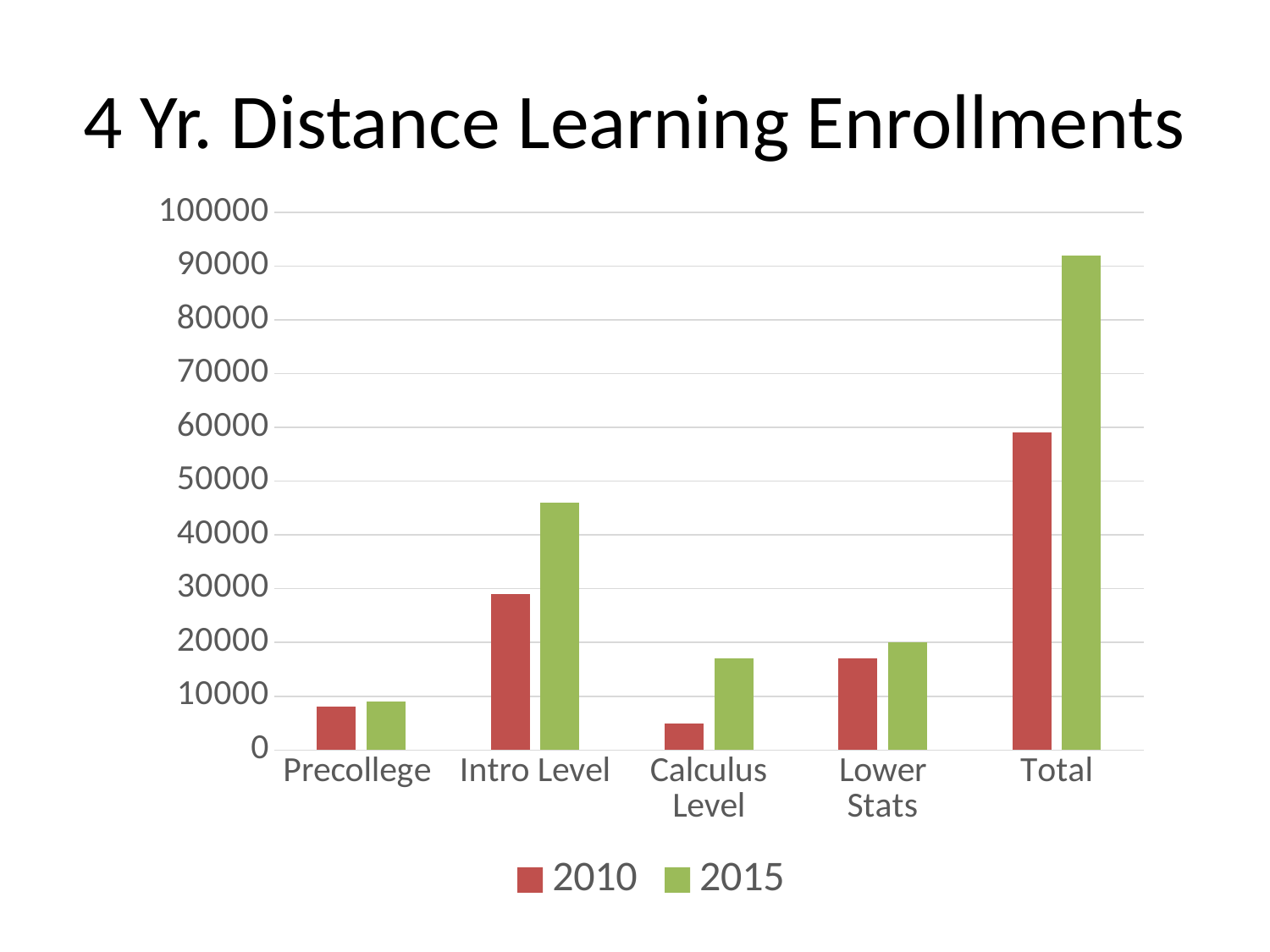
Is the 2015 value for Total greater or less than 90000? greater Is the 2010 value for Calculus Level greater or less than 10000? less How many series does the legend list? 2 Which category has the highest 2015 value? Total What kind of chart is shown on the slide? bar chart How many categories are shown on the x axis? 5 What is the title of the chart? 4 Yr. Distance Learning Enrollments Which is larger for Intro Level, the 2010 value or the 2015 value? 2015 Which is larger, the 2015 value for Calculus Level or the 2015 value for Intro Level? Intro Level Is the 2015 value for Intro Level greater or less than 40000? greater Which category has the lowest 2010 value? Calculus Level